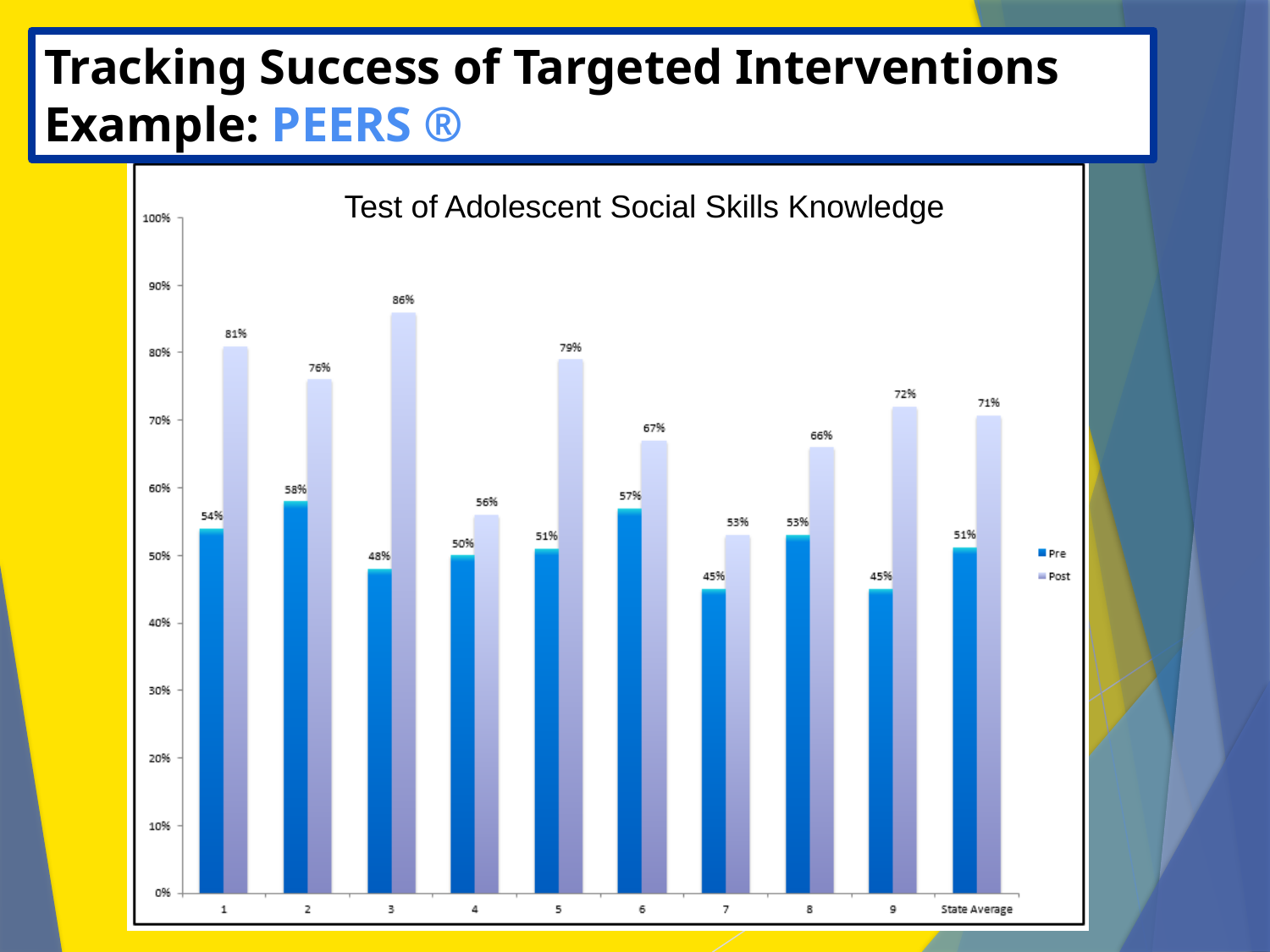
Is the Post value for category 9 greater or less than 70%? greater How many categories are shown on the x axis? 10 What is the title of the chart? Test of Adolescent Social Skills Knowledge What is the Pre value for State Average? 51% Which category has the highest Post value? 3 What is the Post value for category 3? 86% How many series does the legend list? 2 What kind of chart is shown? Bar chart What is the difference between the Post and Pre values for category 1? 27% Which is larger, the Post value for category 2 or the Post value for category 5? Post value for category 5 Which category has the lowest Post value? 7 What is the Pre value for category 7? 45%